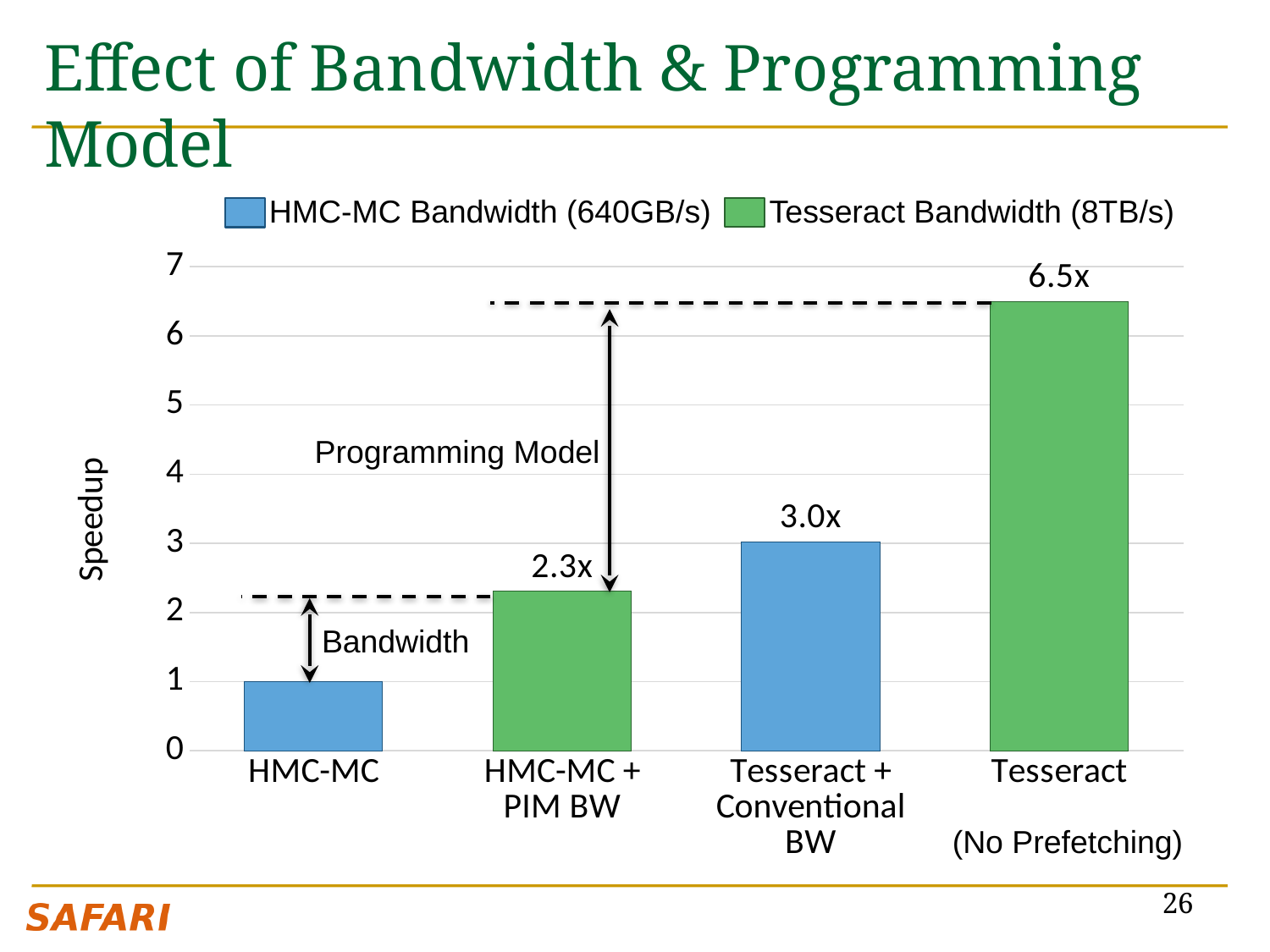
Which has a larger speedup, HMC-MC + PIM BW or Tesseract + Conventional BW? Tesseract + Conventional BW What is the speedup for HMC-MC + PIM BW? 2.3x What is the difference in speedup between Tesseract + Conventional BW and HMC-MC + PIM BW? 0.7x How many series does the legend list? 2 How many categories are shown on the x axis? 4 Is the speedup for HMC-MC greater or less than 2? less What is the speedup for Tesseract + Conventional BW? 3.0x What is the difference in speedup between Tesseract (No Prefetching) and Tesseract + Conventional BW? 3.5x Which category has the highest speedup? Tesseract (No Prefetching) What kind of chart is shown on the slide? bar chart What is the speedup for Tesseract (No Prefetching)? 6.5x Which category has the lowest speedup? HMC-MC